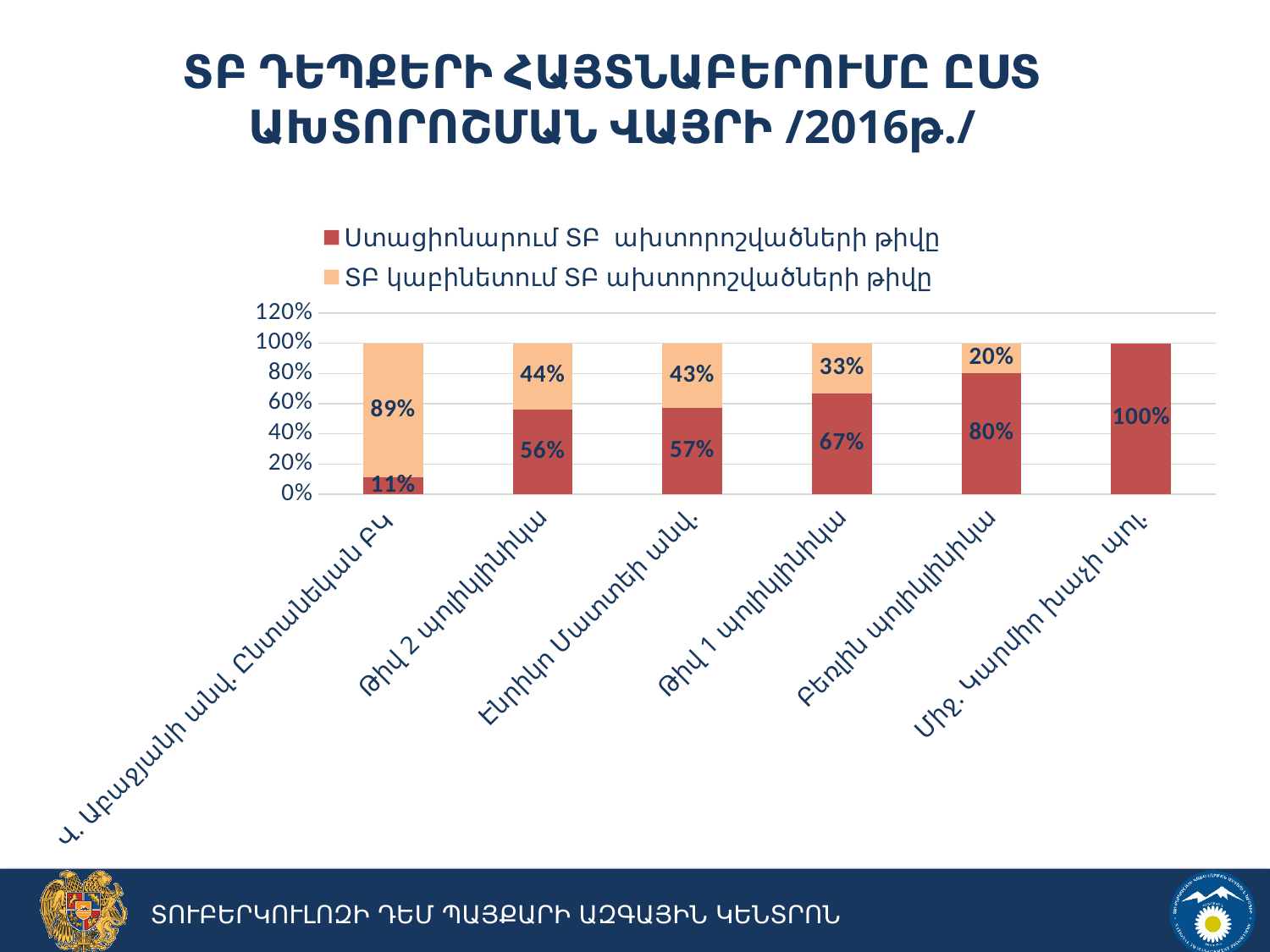
Which category has the lowest value for the 'Ստացիոնարում ՏԲ ախտորոշվածների թիվը' series? Վ. Աբաջյանի անվ. Ընտանեկան ԲԿ Does the 'Ստացիոնարում ՏԲ ախտորոշվածների թիվը' series rise or fall from left to right across the categories? Rise How many categories are shown on the x axis? 6 What type of chart is shown on the slide? Stacked bar chart How many series does the legend list? 2 Which is larger: the 'Ստացիոնարում ՏԲ ախտորոշվածների թիվը' value for 'Էնրիկո Մատտեի անվ.' or for 'Թիվ 1 պոլիկլինիկա'? Թիվ 1 պոլիկլինիկա What is the value of the 'ՏԲ կաբինետում ՏԲ ախտորոշվածների թիվը' series for 'Վ. Աբաջյանի անվ. Ընտանեկան ԲԿ'? 89% Which category has the highest value for the 'Ստացիոնարում ՏԲ ախտորոշվածների թիվը' series? Միջ. Կարմիր խաչի պոլ. What colour represents the 'ՏԲ կաբինետում ՏԲ ախտորոշվածների թիվը' series? Orange What is the difference between the 'ՏԲ կաբինետում ՏԲ ախտորոշվածների թիվը' values for 'Թիվ 2 պոլիկլինիկա' and 'Թիվ 1 պոլիկլինիկա'? 11% What is the value of the 'Ստացիոնարում ՏԲ ախտորոշվածների թիվը' series for 'Բեռլին պոլիկլինիկա'? 80% What is the value of the 'Ստացիոնարում ՏԲ ախտորոշվածների թիվը' series for 'Թիվ 2 պոլիկլինիկա'? 56%